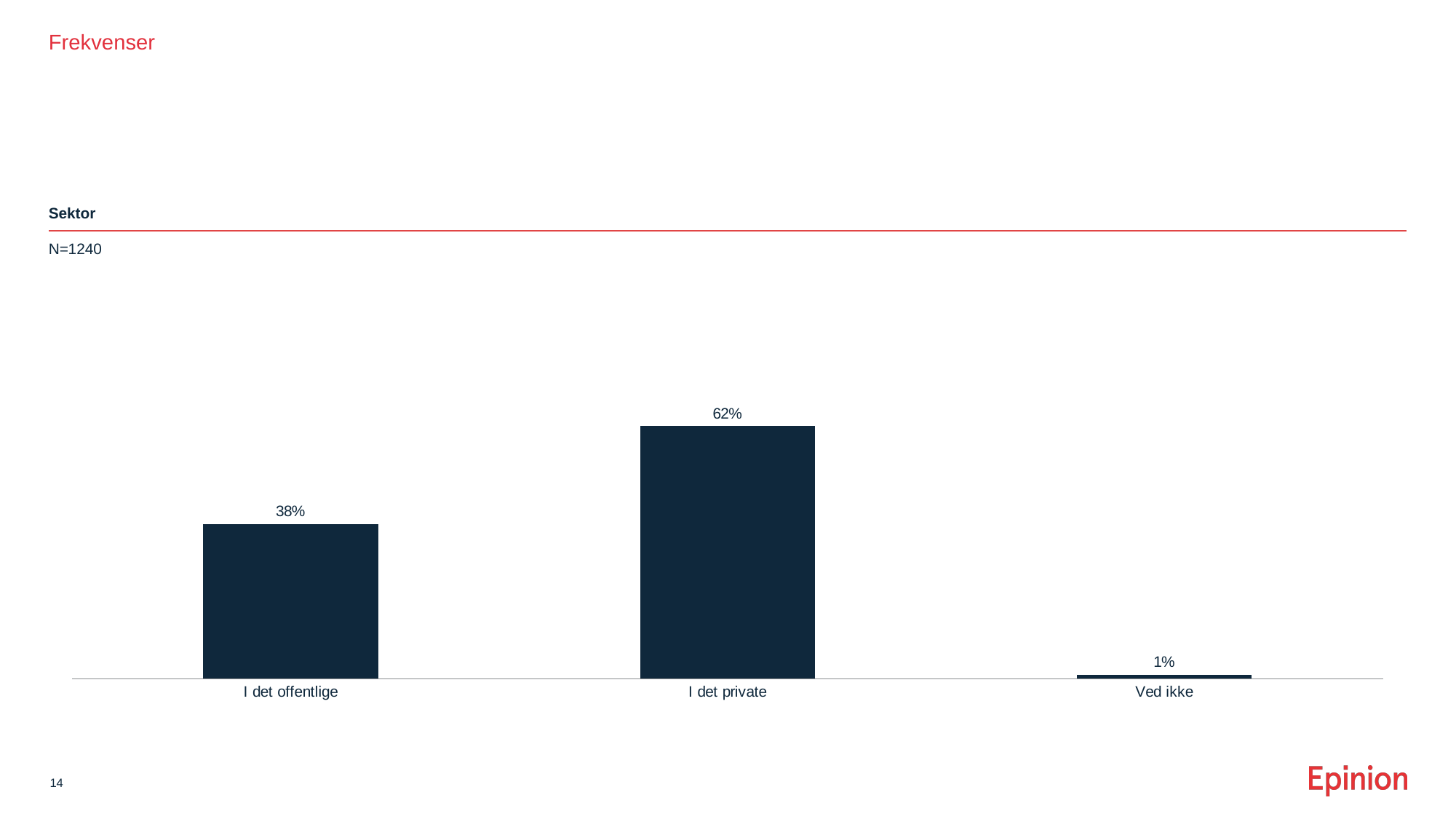
Which is larger, the value for "I det offentlige" or the value for "I det private"? I det private Which category has the highest value? I det private What is the value for "Ved ikke"? 1% What is the difference between the values for "I det private" and "I det offentlige"? 24% What is the difference between the values for "I det offentlige" and "Ved ikke"? 37% What is the value for "I det private"? 62% How many categories are shown in the chart? 3 What kind of chart is shown on the slide? Bar chart What is the title of the chart? Sektor Which category has the lowest value? Ved ikke What is the value for "I det offentlige"? 38% What sample size (N) is stated for the chart? N=1240